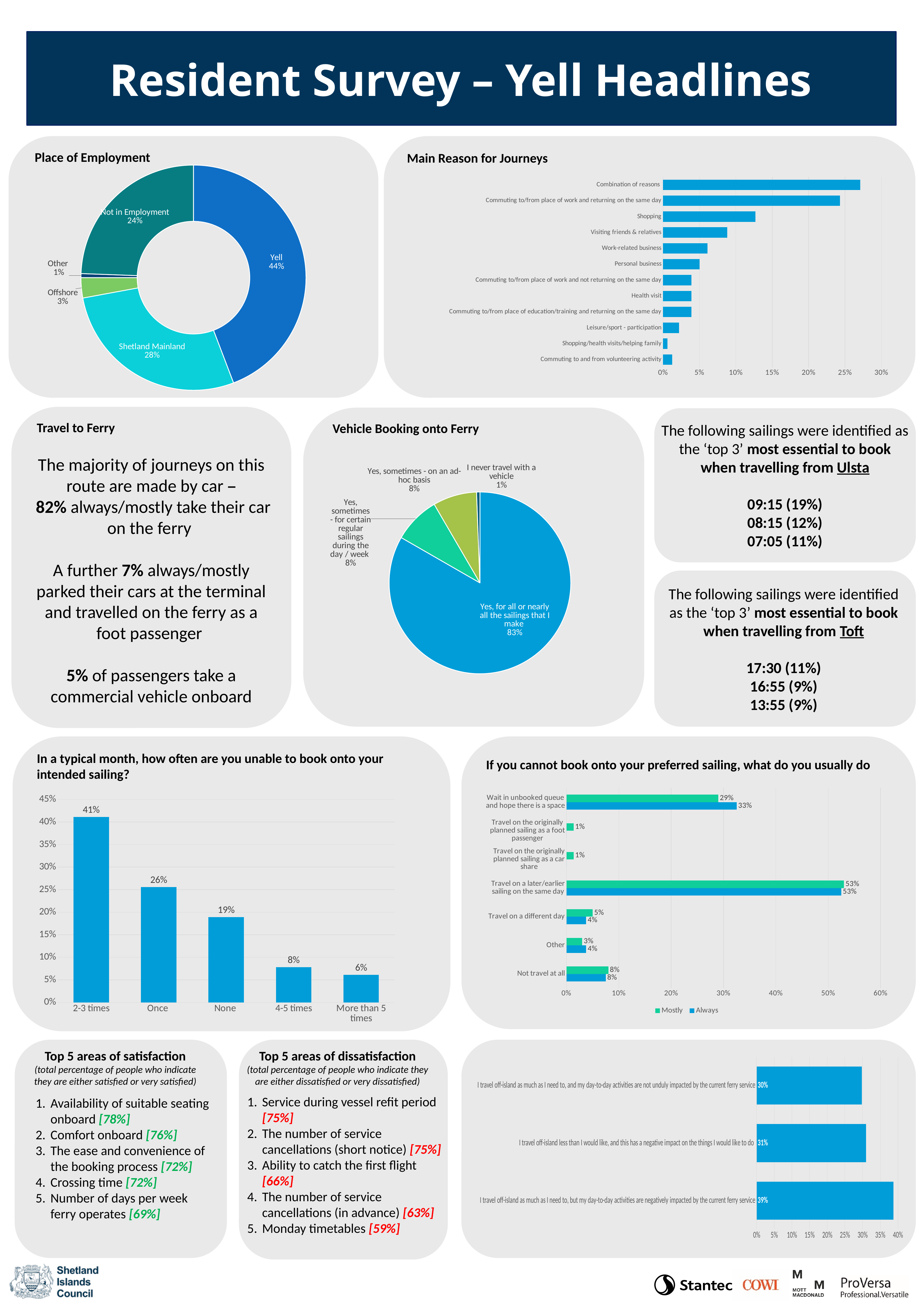
In the Vehicle Booking onto Ferry chart, what percentage never travel with a vehicle? 1% How many series does the legend list in the chart 'If you cannot book onto your preferred sailing, what do you usually do'? 2 In the Vehicle Booking onto Ferry chart, what share of respondents book for all or nearly all the sailings they make? 83% In the bottom-right bar chart, what is the value for 'I travel off-island as much as I need to, but my day-to-day activities are negatively impacted by the current ferry service'? 39% In the Place of Employment chart, what percentage of respondents work on Yell? 44% In the chart 'If you cannot book onto your preferred sailing, what do you usually do', what is the Always value for 'Wait in unbooked queue and hope there is a space'? 33% In the Place of Employment chart, which category has the smallest share? Other In the Main Reason for Journeys chart, which reason has the longest bar? Combination of reasons How many categories are shown in the chart 'In a typical month, how often are you unable to book onto your intended sailing?' 5 In the Main Reason for Journeys chart, is the value for Shopping greater or less than 10%? greater In the chart 'In a typical month, how often are you unable to book onto your intended sailing?', what is the value for 2-3 times? 41% In the chart 'In a typical month, how often are you unable to book onto your intended sailing?', what is the difference between Once and None? 7%